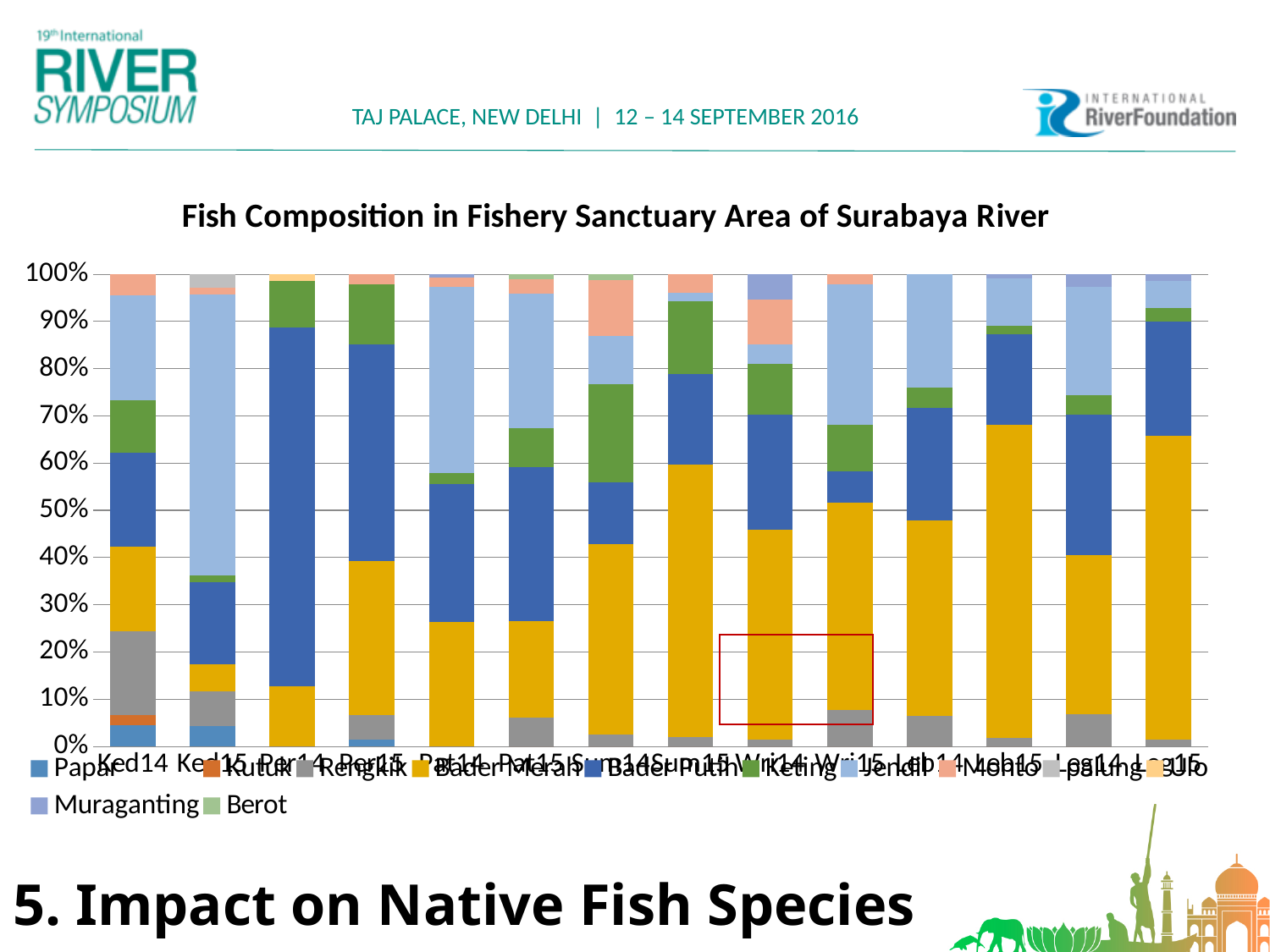
Is the share of Jendil in the second bar from the left greater or less than 50%? greater How many series does the chart's legend list? 12 Is the share of Bader Putih in the first (leftmost) bar greater or less than 30%? less What is the highest value shown on the chart's vertical axis? 100% How many bars are plotted in the chart? 14 What is the title of the chart? Fish Composition in Fishery Sanctuary Area of Surabaya River What kind of chart is shown on the slide? Stacked bar chart Is the share of Bader Merah in the last (rightmost) bar greater or less than 50%? greater In the first (leftmost) bar, which segment is larger: Rengkik or Keting? Rengkik